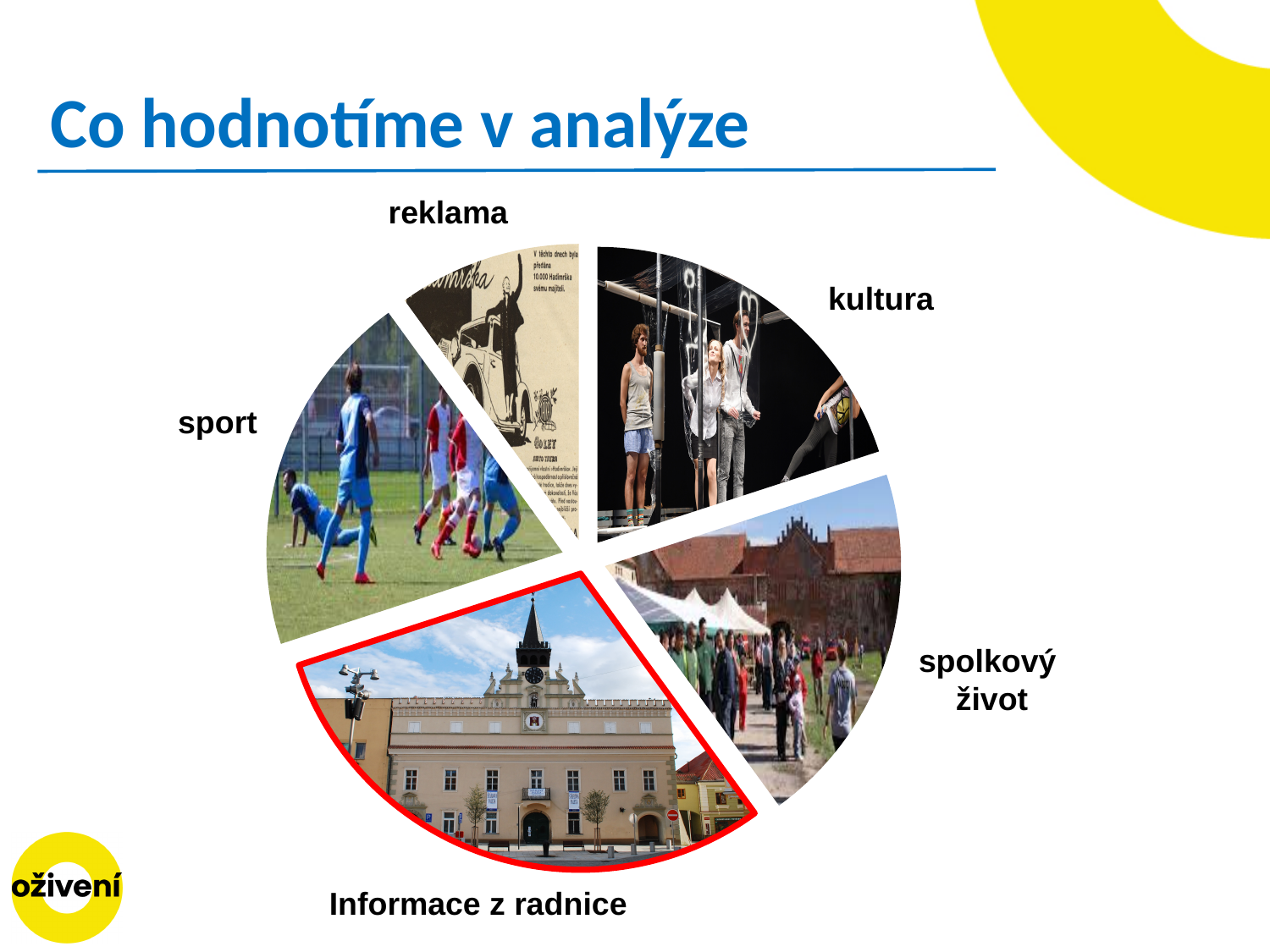
How many slices does the pie chart have? 5 Which slice of the pie chart is labelled at the bottom of the chart? Informace z radnice Which slice of the pie chart is labelled on the upper right side of the chart? kultura What kind of chart is shown on the slide? pie chart What is the title of the slide containing the pie chart? Co hodnotíme v analýze Which slice of the pie chart is labelled at the top of the chart? reklama Which slice of the pie chart is labelled on the lower right side of the chart? spolkový život Which slice of the pie chart is outlined in red? Informace z radnice Which slice of the pie chart is labelled on the left side of the chart? sport